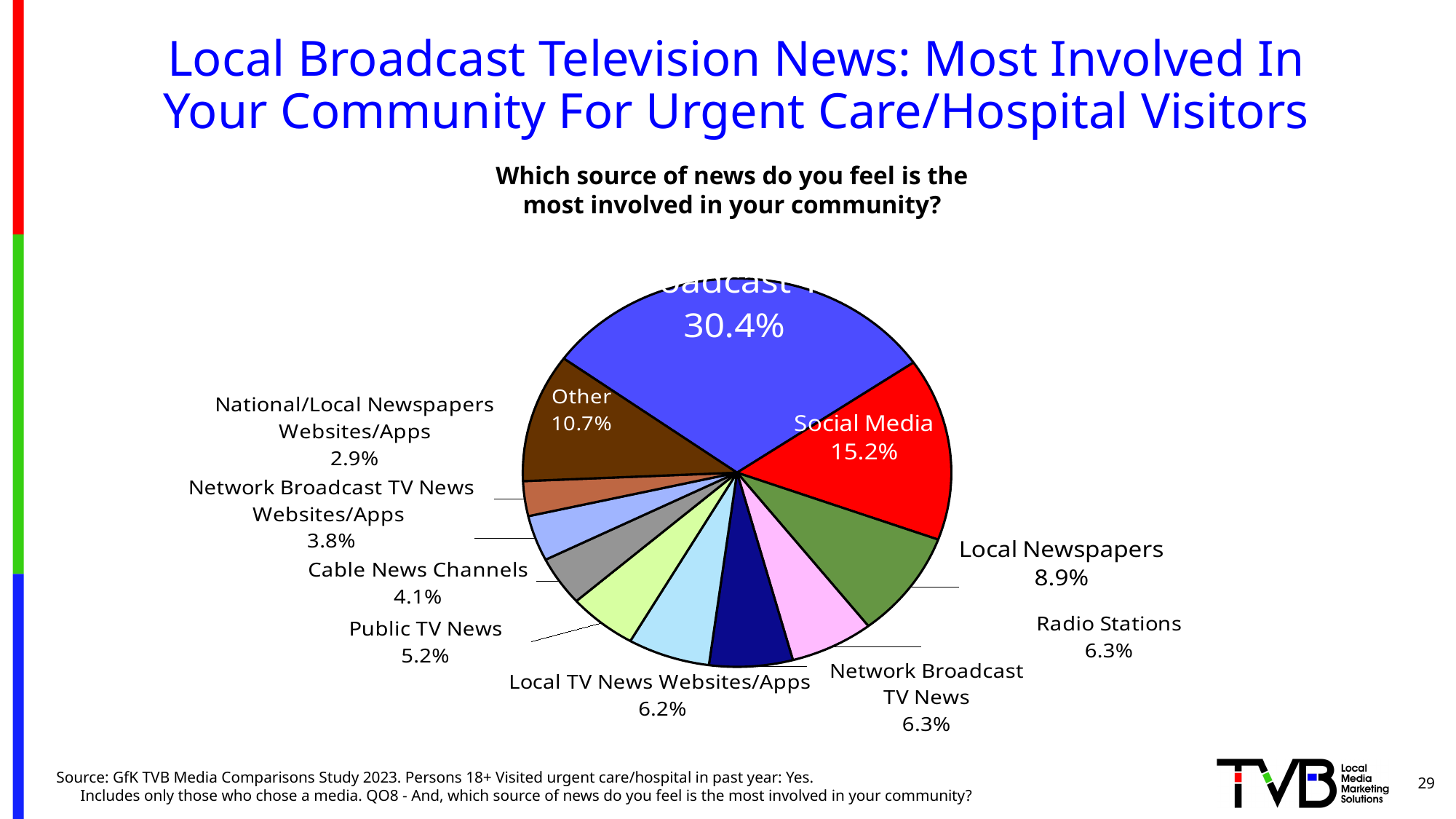
What percentage is shown for the Other slice? 10.7% What kind of chart is shown on the slide? pie chart What percentage is printed on the largest slice of the pie? 30.4% How many percentage points larger is Social Media than Local Newspapers? 6.3 percentage points How many slices does the pie chart have? 11 What percentage of the pie is Social Media? 15.2% What share does Local Newspapers have in the pie chart? 8.9% What percentage is shown for Radio Stations? 6.3% Which category has the smallest slice in the pie chart? National/Local Newspapers Websites/Apps What value is shown for Cable News Channels? 4.1% What colour is the Social Media slice? red Which is larger, Public TV News or Cable News Channels? Public TV News